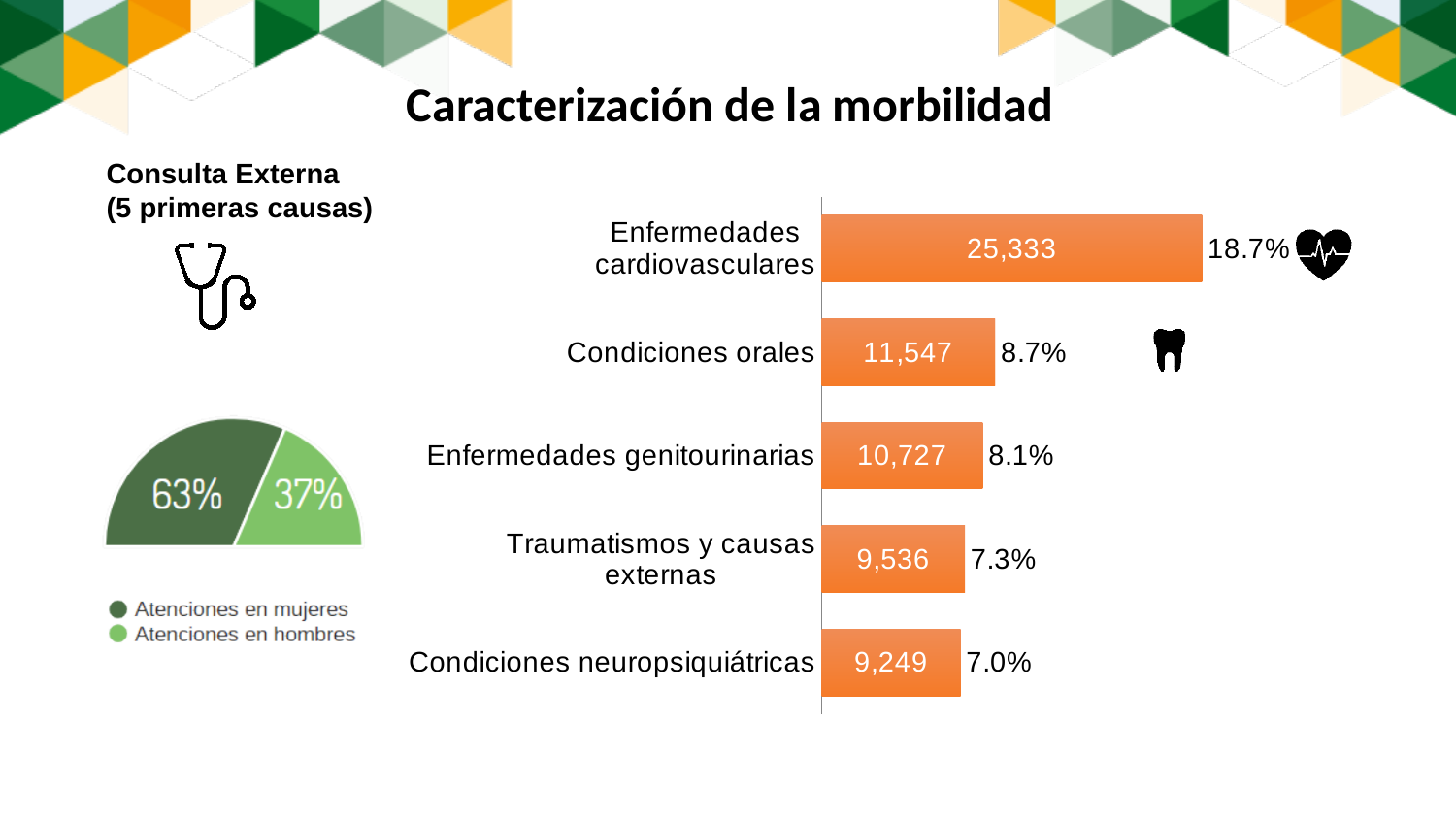
In the bar chart, what percentage is shown next to Condiciones orales? 8.7% What kind of chart is the chart on the right of the slide? Bar chart In the semicircle chart on the left, which is larger: Atenciones en mujeres or Atenciones en hombres? Atenciones en mujeres In the semicircle chart on the left, what share is Atenciones en mujeres? 63% In the bar chart, what is the difference between the values for Condiciones orales and Enfermedades genitourinarias? 820 How many categories does the bar chart show? 5 In the bar chart, which is larger: the value for Enfermedades genitourinarias or Condiciones neuropsiquiátricas? Enfermedades genitourinarias In the bar chart, what is the value for Traumatismos y causas externas? 9,536 In the bar chart, what is the value for Enfermedades cardiovasculares? 25,333 In the bar chart, which category has the lowest value? Condiciones neuropsiquiátricas In the bar chart, which category has the highest value? Enfermedades cardiovasculares In the bar chart, what is the difference between the values for Enfermedades cardiovasculares and Condiciones orales? 13,786